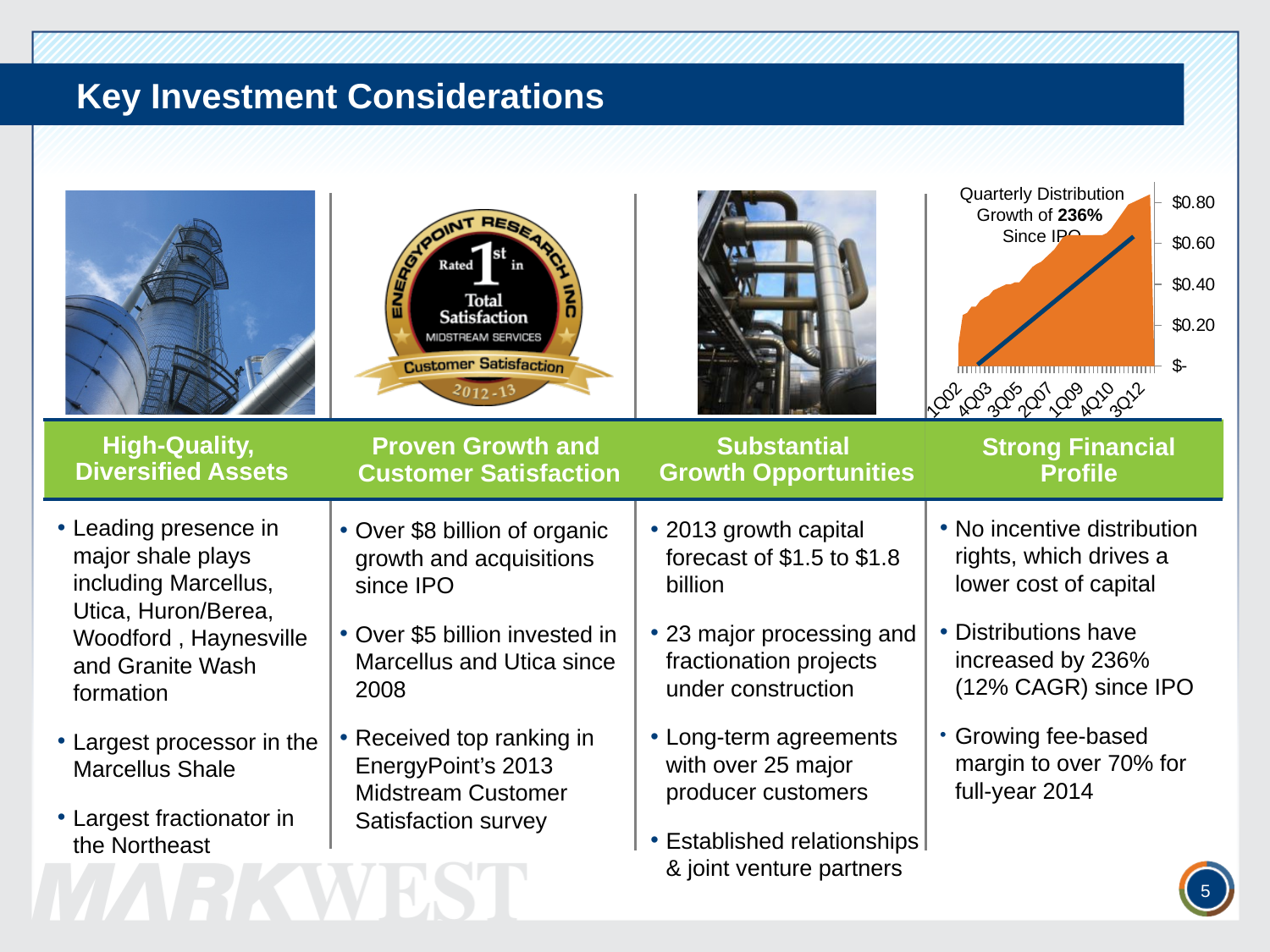
Do the quarterly distribution values in the chart generally rise or fall from 1Q02 to 3Q12? rise Is the quarterly distribution value for 3Q12 greater or less than $0.60? greater Is the quarterly distribution value for 4Q03 greater or less than $0.20? greater How many period labels are shown on the x axis of the quarterly distribution chart? 7 What kind of chart is shown in the Strong Financial Profile section of the slide? area chart Is the quarterly distribution value for 4Q10 greater or less than $0.40? greater According to the annotation on the chart, what is the quarterly distribution growth since IPO? 236% Which period has the larger quarterly distribution value, 1Q02 or 3Q12? 3Q12 What is the highest value labeled on the y axis of the quarterly distribution chart? $0.80 Which period has the larger quarterly distribution value, 4Q03 or 4Q10? 4Q10